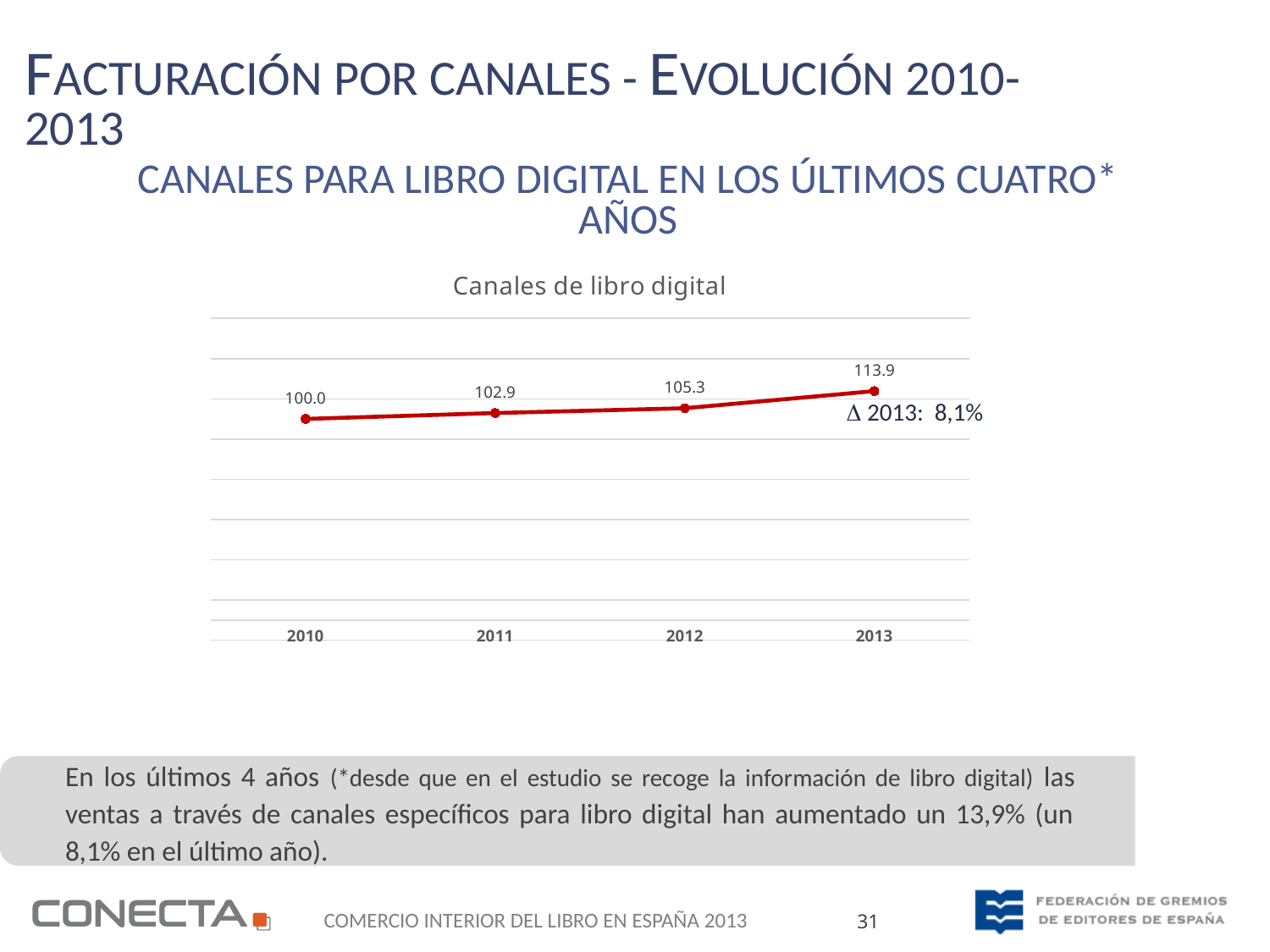
What is the difference between the 2013 and 2012 values in the 'Canales de libro digital' chart? 8.6 Which year has the lowest value in the 'Canales de libro digital' chart? 2010 Do the values in the 'Canales de libro digital' chart rise or fall from 2010 to 2013? Rise What is the value for 2011 in the 'Canales de libro digital' chart? 102.9 What is the value for 2012 in the 'Canales de libro digital' chart? 105.3 Which year has the highest value in the 'Canales de libro digital' chart? 2013 What is the value for 2010 in the 'Canales de libro digital' chart? 100.0 Which is larger in the 'Canales de libro digital' chart, the value for 2011 or the value for 2012? 2012 What is the value for 2013 in the 'Canales de libro digital' chart? 113.9 What is the difference between the 2013 and 2010 values in the 'Canales de libro digital' chart? 13.9 How many data points are plotted in the 'Canales de libro digital' chart? 4 What kind of chart is 'Canales de libro digital'? Line chart